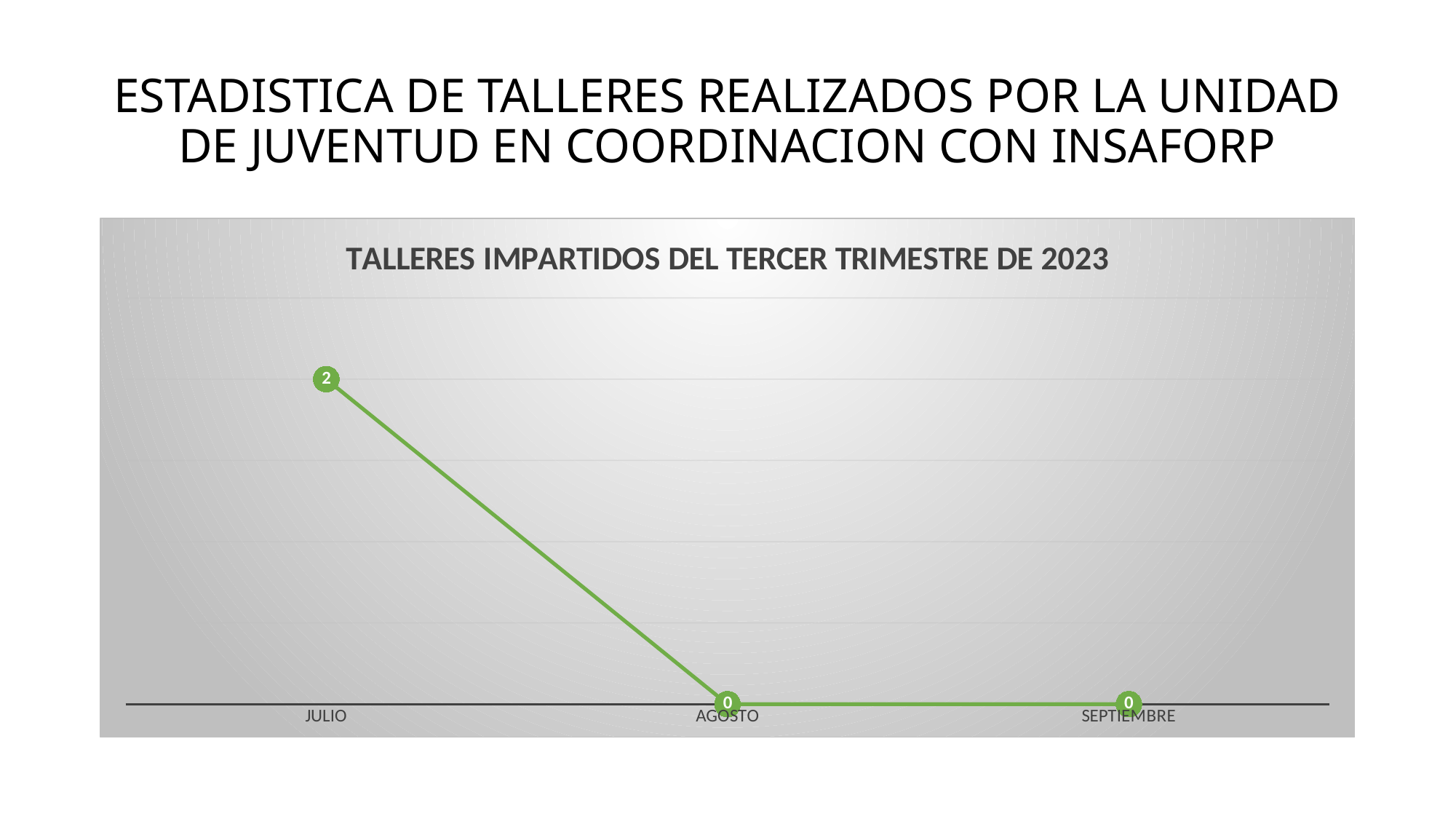
What is the value for AGOSTO? 0 What is the value for SEPTIEMBRE? 0 How many months are plotted on the chart? 3 What is the difference between the values for JULIO and AGOSTO? 2 What colour is the line on the chart? green Which is larger, the value for JULIO or the value for SEPTIEMBRE? JULIO What is the total of the values for the three months? 2 Which month has the highest value? JULIO What kind of chart is shown? line chart What is the title of the chart? TALLERES IMPARTIDOS DEL TERCER TRIMESTRE DE 2023 Do the values rise or fall from JULIO to AGOSTO? fall What is the value for JULIO? 2